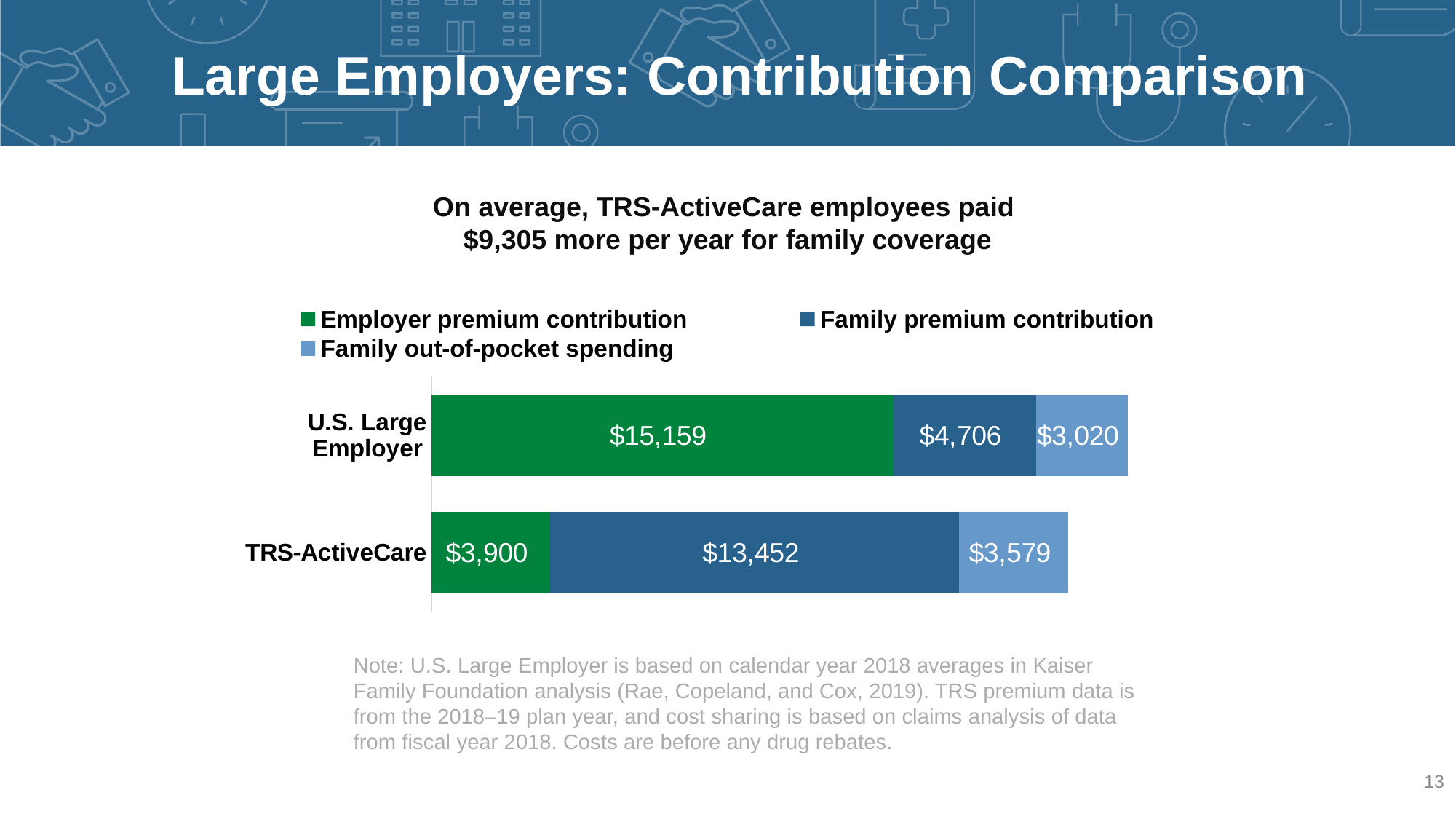
What is the Family premium contribution for TRS-ActiveCare? $13,452 How many series does the legend list? 3 What is the Family out-of-pocket spending for U.S. Large Employer? $3,020 What is the Employer premium contribution for U.S. Large Employer? $15,159 What is the Employer premium contribution for TRS-ActiveCare? $3,900 What is the total of the stacked bar for TRS-ActiveCare? $20,931 What kind of chart is shown on the slide? Stacked bar chart What is the difference in Family out-of-pocket spending between TRS-ActiveCare and U.S. Large Employer? $559 What is the total of the stacked bar for U.S. Large Employer? $22,885 Which category has the higher Employer premium contribution? U.S. Large Employer What is the difference in Family premium contribution between TRS-ActiveCare and U.S. Large Employer? $8,746 Which category has the higher Family premium contribution, U.S. Large Employer or TRS-ActiveCare? TRS-ActiveCare